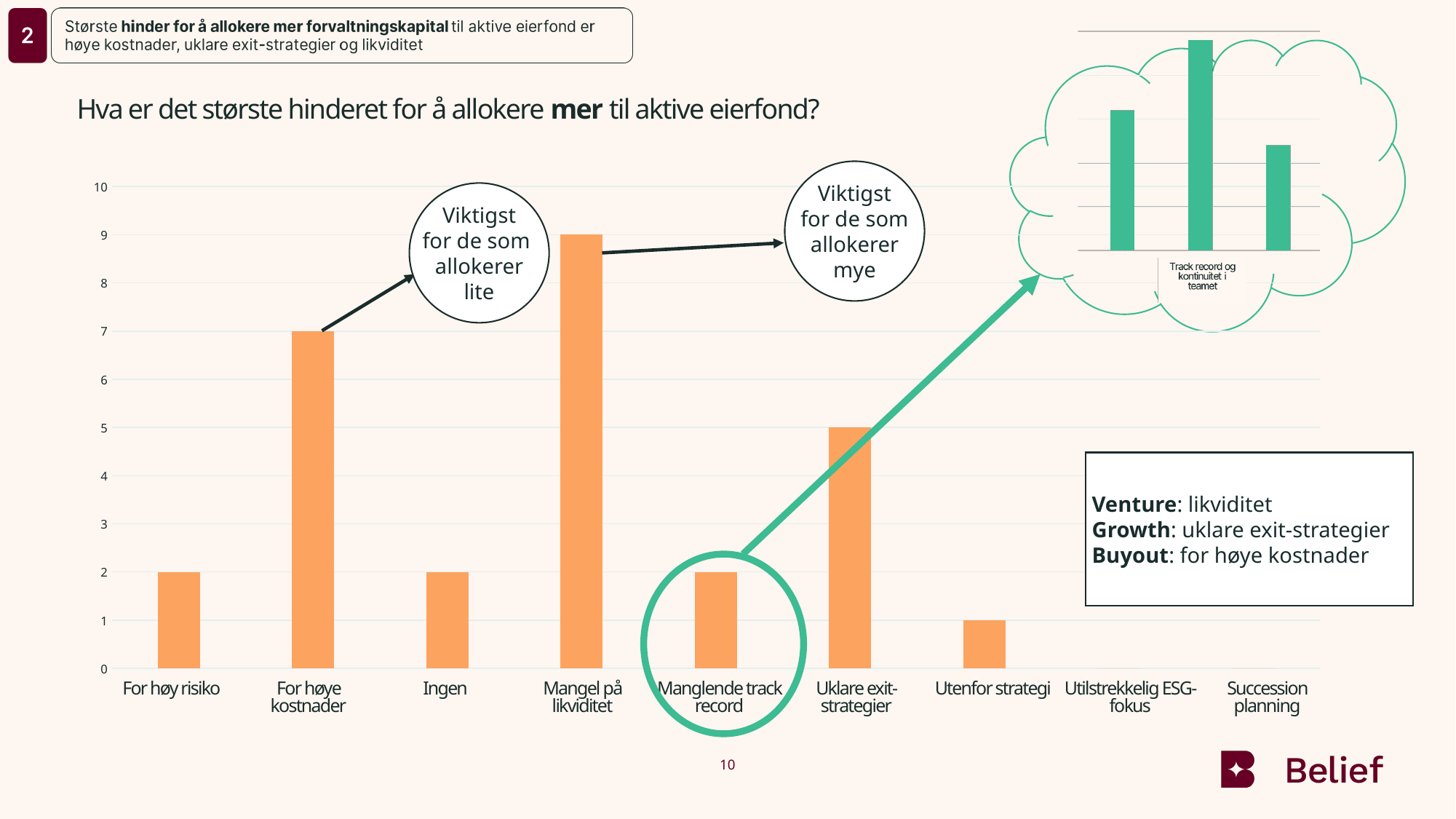
In the main chart, what is the value for 'For høye kostnader'? 7 In the main chart, is the value for 'For høye kostnader' greater or less than 5? greater In the main chart, which category has the highest value? Mangel på likviditet In the main chart 'Hva er det største hinderet for å allokere mer til aktive eierfond?', what is the value for 'Mangel på likviditet'? 9 In the main chart, which is larger: 'Uklare exit-strategier' or 'Manglende track record'? Uklare exit-strategier What colour are the bars in the main chart? Orange In the main chart, what is the value for 'For høy risiko'? 2 In the main chart, what is the value for 'Uklare exit-strategier'? 5 In the main chart, what is the difference between 'Mangel på likviditet' and 'For høye kostnader'? 2 What kind of chart is the main chart on the slide? Bar chart How many categories are shown on the x axis of the main chart? 9 In the main chart, what is the value for 'Utenfor strategi'? 1